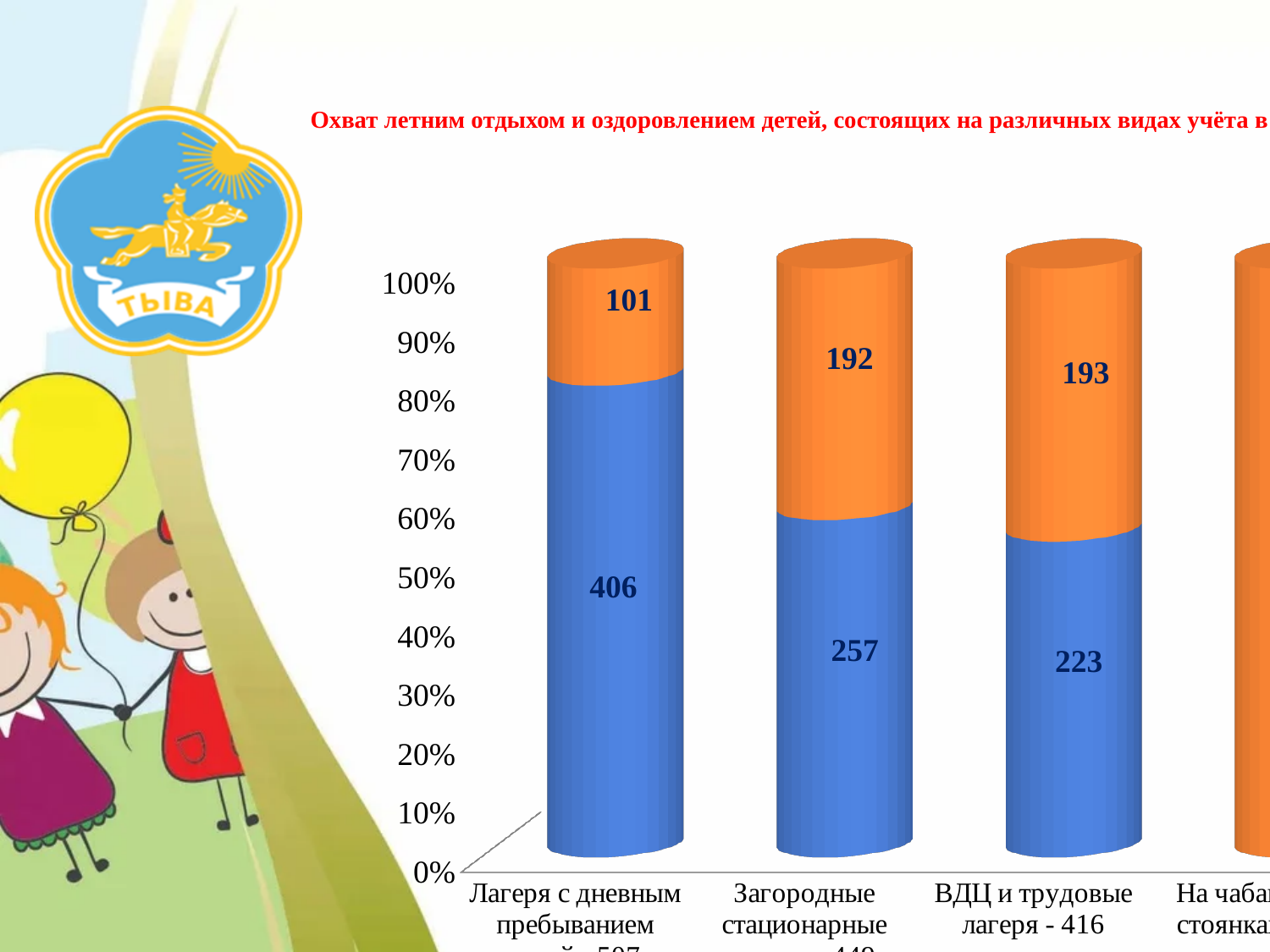
What is the total of the two segments in the "Загородные стационарные" bar? 449 What is the value of the orange segment for "Лагеря с дневным пребыванием"? 101 Is the share of the blue segment in the "Лагеря с дневным пребыванием" bar greater or less than 70%? greater Which is larger in the "ВДЦ и трудовые лагеря" bar, the blue segment or the orange segment? the blue segment What is the total of the two segments in the "ВДЦ и трудовые лагеря" bar? 416 What kind of chart is shown on the slide? bar chart What is the value of the blue segment for "Загородные стационарные"? 257 Which category has the smallest orange segment value? Лагеря с дневным пребыванием What is the value of the orange segment for "ВДЦ и трудовые лагеря"? 193 Which category has the largest blue segment value? Лагеря с дневным пребыванием What is the difference between the blue and orange segments for "Лагеря с дневным пребыванием"? 305 What is the value of the blue segment for "Лагеря с дневным пребыванием"? 406